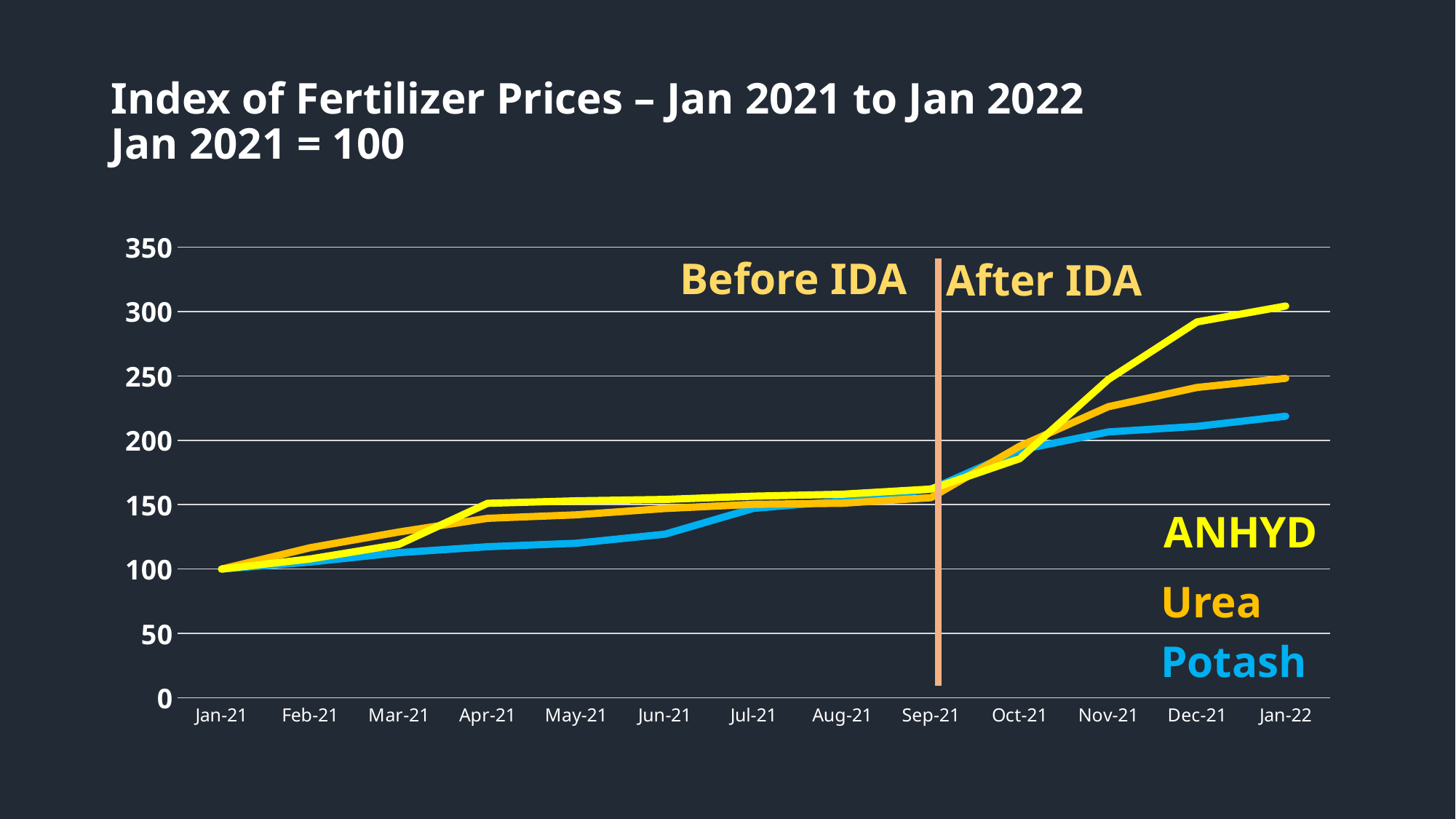
Is the value for Urea in Nov-21 greater or less than 200? greater Is the value for Potash in Jan-22 greater or less than 200? greater Which is larger in Dec-21, the index for ANHYD or the index for Potash? ANHYD How many series does the chart show? 3 What two labels appear on either side of the vertical line in the chart? Before IDA and After IDA Is the value for Potash in Jun-21 greater or less than 150? less Do the fertilizer price indices rise or fall from Jan-21 to Jan-22? Rise Which fertilizer has the lowest index value in Jan-22? Potash What kind of chart is shown on the slide? Line chart How many months are plotted along the x axis? 13 What is the index value of all three fertilizers in Jan-21? 100 Which fertilizer has the highest index value in Jan-22? ANHYD